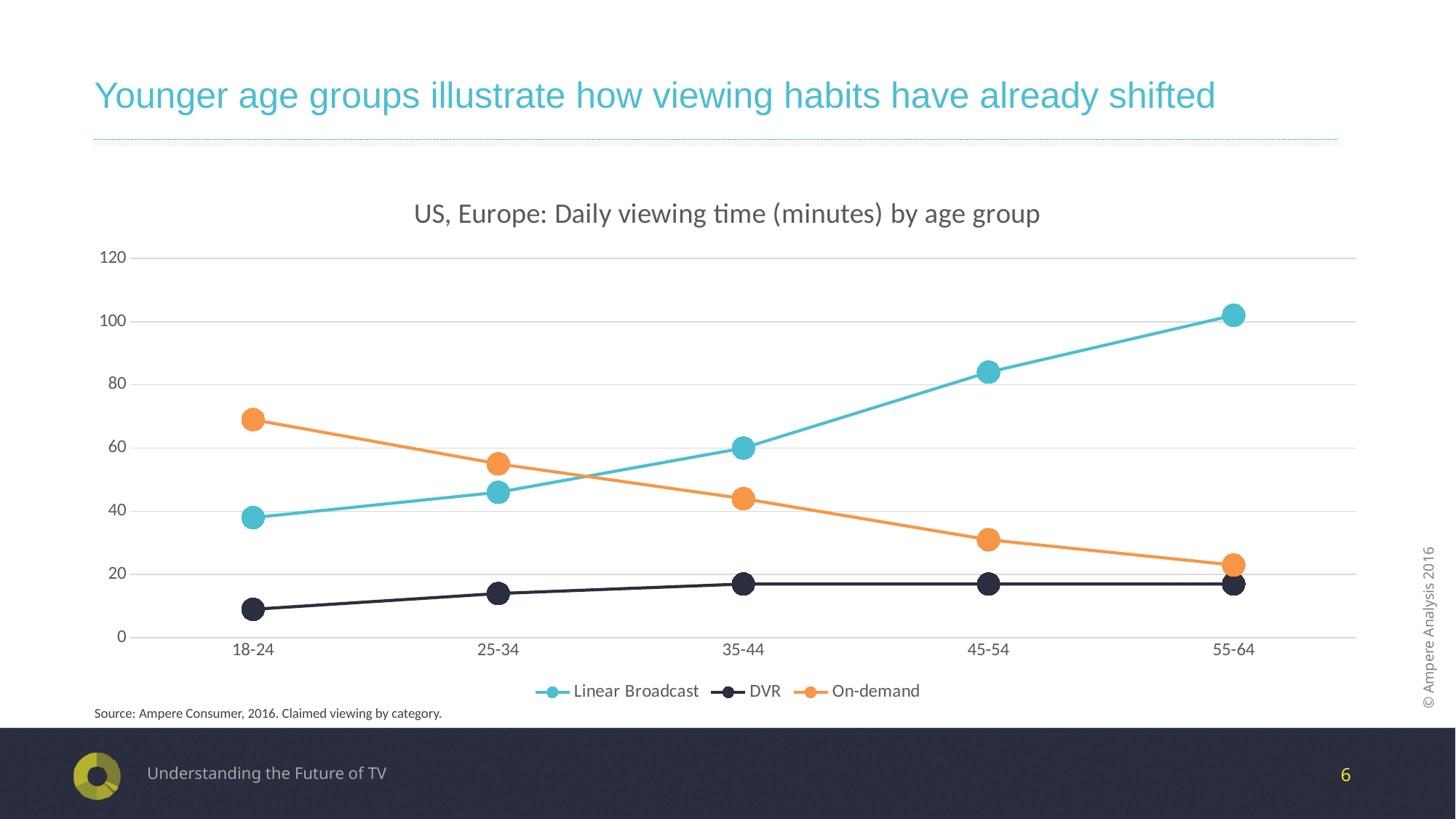
Does the On-demand viewing time rise or fall as age group increases from 18-24 to 55-64? Fall How many age groups are plotted along the x axis? 5 How many series does the legend list? 3 What is the title of the chart? US, Europe: Daily viewing time (minutes) by age group Which age group has the lowest On-demand viewing time? 55-64 For the 35-44 age group, which is larger: Linear Broadcast or On-demand? Linear Broadcast Which age group has the lowest DVR viewing time? 18-24 Which age group has the highest Linear Broadcast viewing time? 55-64 Is the On-demand value for the 18-24 age group greater or less than 60? greater For the 18-24 age group, which is larger: Linear Broadcast or On-demand? On-demand What kind of chart is shown on the slide? Line chart Is the Linear Broadcast value for the 55-64 age group greater or less than 80? greater